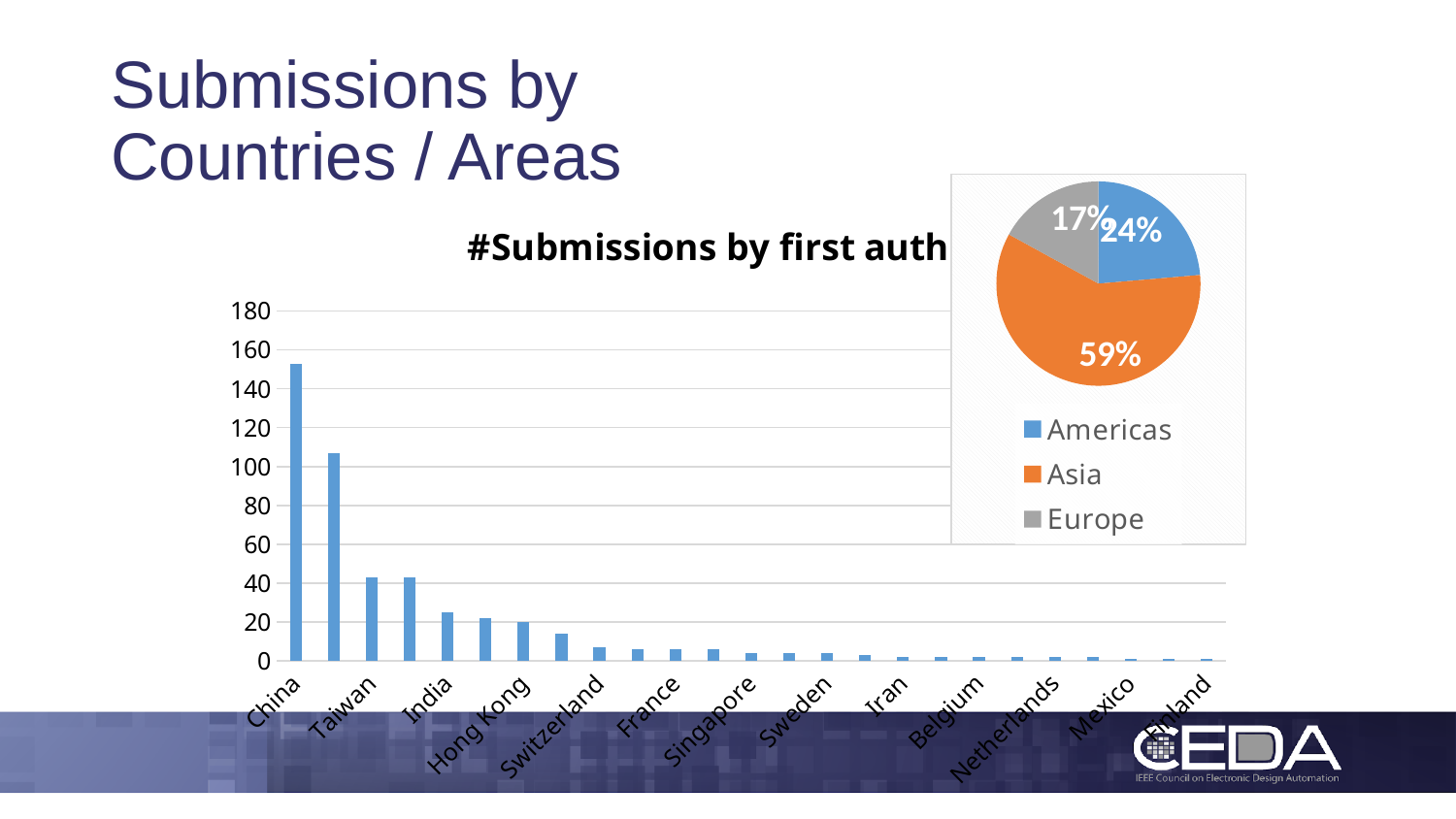
In the bar chart on the left, is the value for Taiwan greater or less than 100? less In the pie chart on the right, what share of submissions is from Europe? 17% In the pie chart on the right, what share of submissions is from Asia? 59% In the pie chart on the right, which region has the largest share? Asia In the bar chart on the left, do the values rise or fall moving from left to right along the x axis? Fall How many regions does the legend of the pie chart on the right list? 3 In the pie chart on the right, what share of submissions is from the Americas? 24% In the bar chart on the left, which country has the highest number of submissions? China What kind of chart is the large chart on the left of the slide? Bar chart In the pie chart on the right, how many percentage points larger is Asia's share than the Americas' share? 35 In the pie chart on the right, which region has the smallest share? Europe In the bar chart on the left, is the value for China greater or less than 140? greater